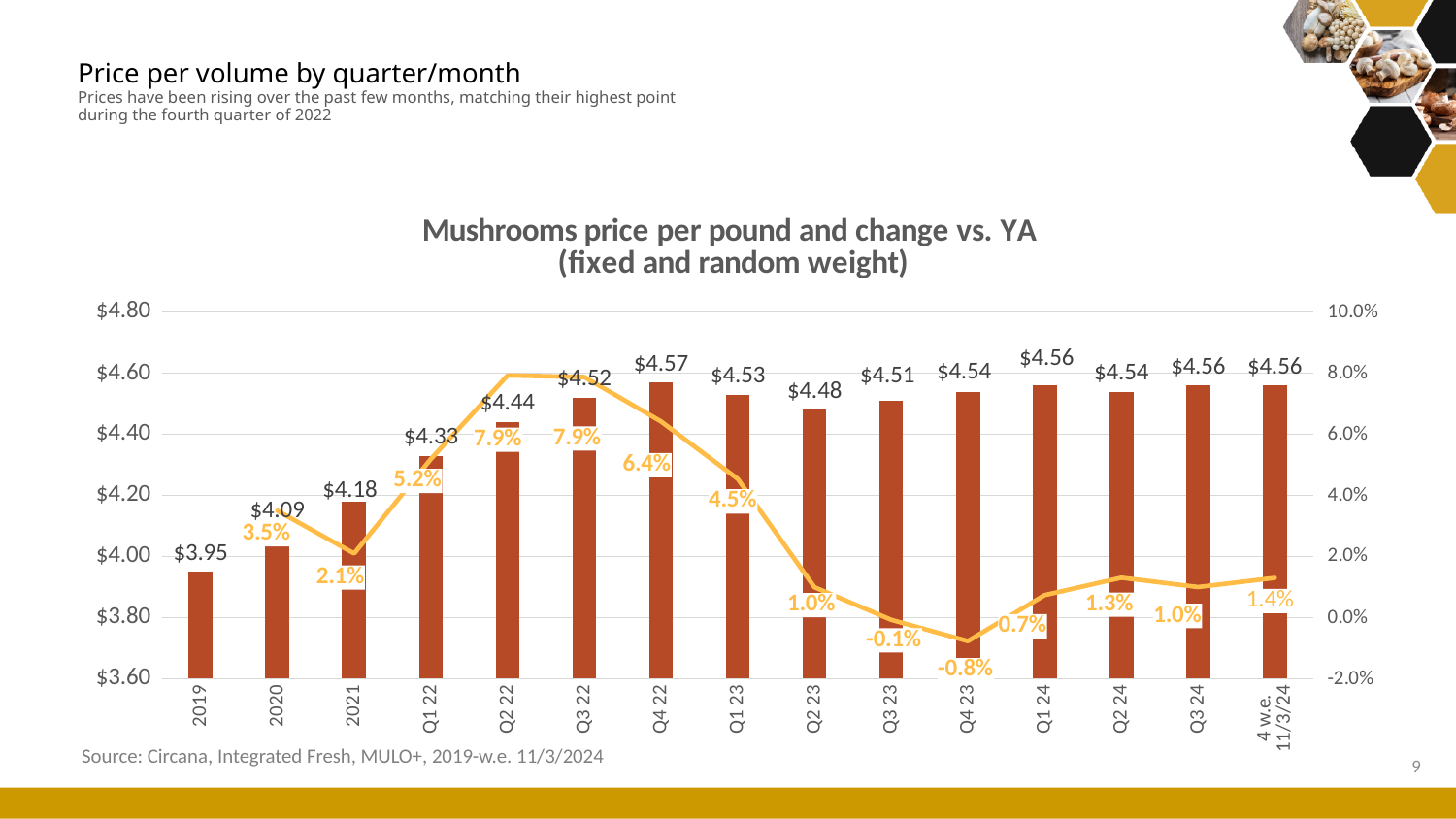
What kind of chart is this? Bar chart with a line overlay What is the mushroom price per pound shown for 2019? $3.95 Do the price per pound bars rise or fall from 2019 to Q4 22? Rise Which period has the lowest change vs. YA on the line? Q4 23 What is the mushroom price per pound shown for Q4 22? $4.57 How many periods are shown on the x axis? 15 What is the change vs. YA shown for Q4 23? -0.8% What is the change vs. YA shown for Q2 22? 7.9% Which period has the highest price per pound? Q4 22 Which period has the higher price per pound, Q2 22 or Q3 22? Q3 22 What is the difference between the price per pound in Q4 22 and in 2019? $0.62 Which period has the lowest price per pound? 2019